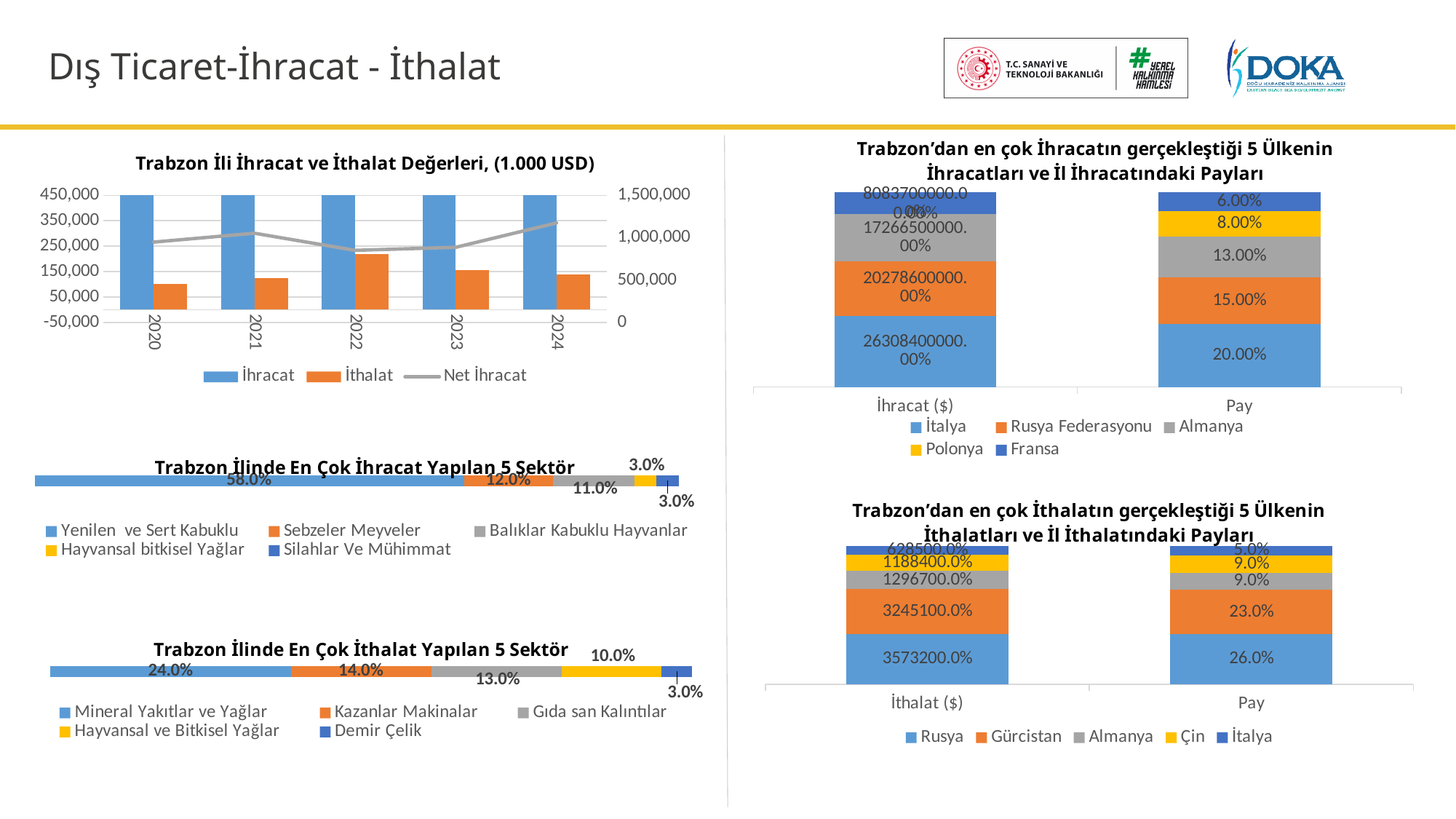
In the chart 'Trabzon'dan en çok İthalatın gerçekleştiği 5 Ülkenin İthalatları ve İl İthalatındaki Payları', which is larger in the Pay bar: Rusya or Gürcistan? Rusya In the chart 'Trabzon'dan en çok İhracatın gerçekleştiği 5 Ülkenin İhracatları ve İl İhracatındaki Payları', which country has the largest Pay value? İtalya In the chart 'Trabzon İlinde En Çok İhracat Yapılan 5 Sektör', what is the difference between the Sebzeler Meyveler share and the Balıklar Kabuklu Hayvanlar share? 1.0% In the chart 'Trabzon İli İhracat ve İthalat Değerleri, (1.000 USD)', is the İthalat value for 2022 greater or less than 150,000? greater In the chart 'Trabzon İlinde En Çok İthalat Yapılan 5 Sektör', what is the share for Kazanlar Makinalar? 14.0% In the chart 'Trabzon İli İhracat ve İthalat Değerleri, (1.000 USD)', how many series does the legend list? 3 In the chart 'Trabzon'dan en çok İthalatın gerçekleştiği 5 Ülkenin İthalatları ve İl İthalatındaki Payları', what is the Pay value for İtalya? 5.0% In the chart 'Trabzon'dan en çok İhracatın gerçekleştiği 5 Ülkenin İhracatları ve İl İhracatındaki Payları', what is the Pay value for Almanya? 13.00% In the chart 'Trabzon İlinde En Çok İthalat Yapılan 5 Sektör', which sector has the lowest share? Demir Çelik In the chart 'Trabzon İli İhracat ve İthalat Değerleri, (1.000 USD)', which year has the highest İthalat bar? 2022 In the chart 'Trabzon İli İhracat ve İthalat Değerleri, (1.000 USD)', how many years are shown on the x axis? 5 In the chart 'Trabzon İlinde En Çok İhracat Yapılan 5 Sektör', what is the share for Yenilen ve Sert Kabuklu? 58.0%